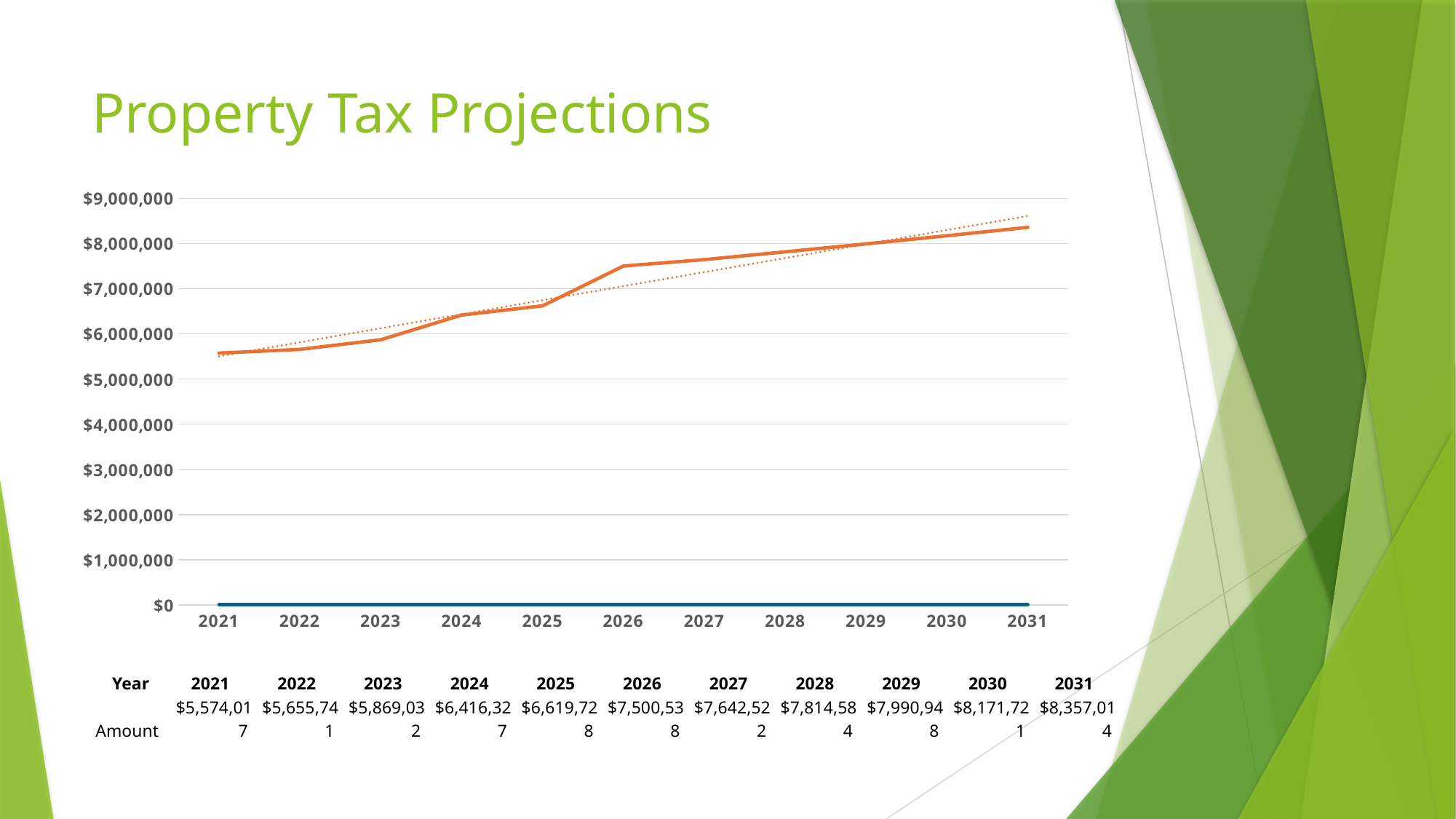
How many years are plotted along the x axis? 11 Which year has the highest Amount? 2031 What is the difference between the Amount for 2026 and the Amount for 2025? $880,810 Is the Amount for 2026 greater or less than $7,000,000? greater What is the title of the slide's chart? Property Tax Projections What kind of chart is shown on the slide? Line chart What is the Amount for 2031? $8,357,014 What is the Amount for 2021? $5,574,017 Which year has the lowest Amount? 2021 What is the Amount for 2026? $7,500,538 What is the difference between the Amount for 2031 and the Amount for 2021? $2,782,997 Does the Amount rise or fall from 2021 to 2031? Rises